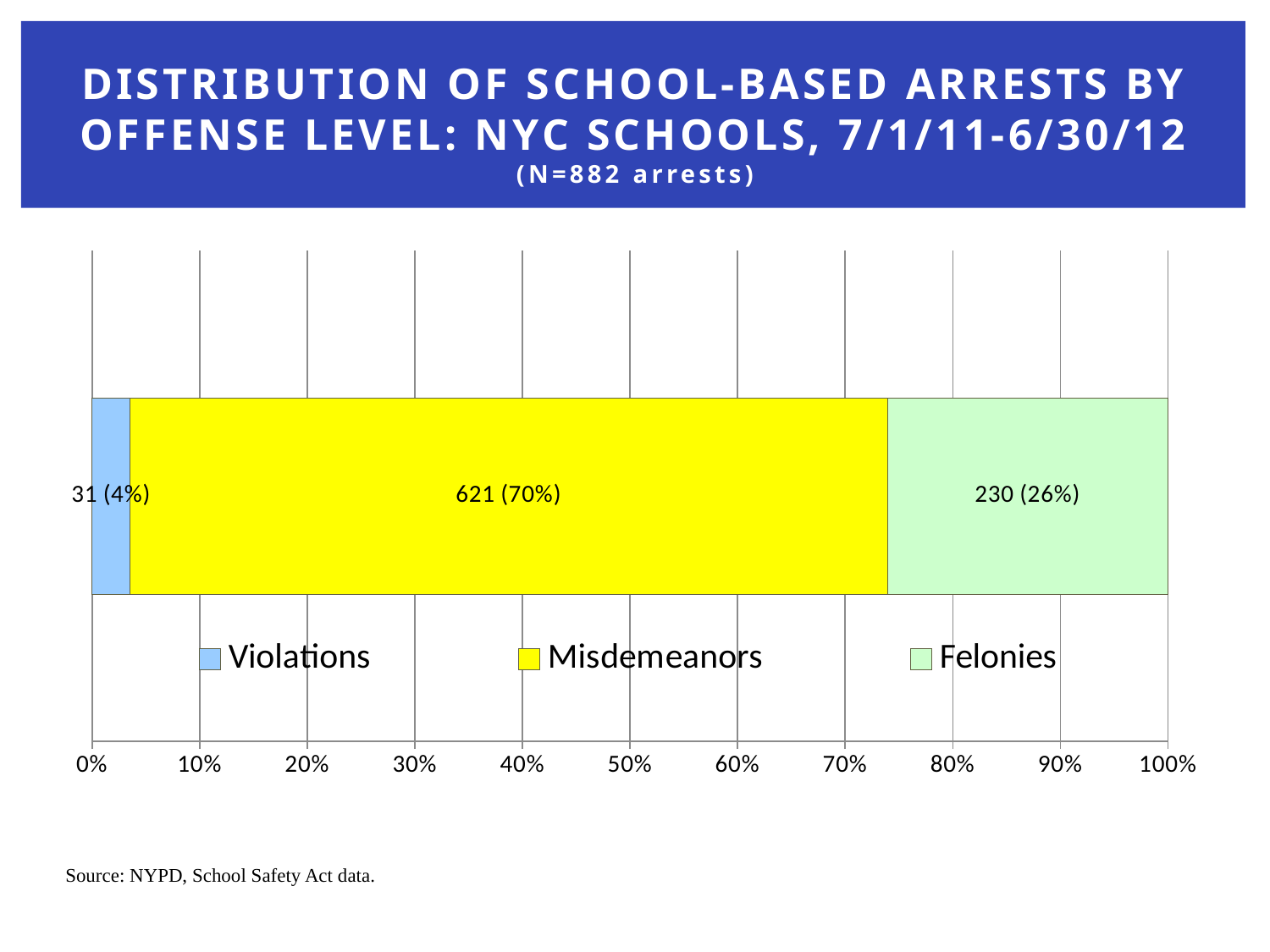
How many arrests were Misdemeanors? 621 How many series does the legend list? 3 Which offense level accounts for the smallest share of arrests? Violations How many arrests were Violations? 31 Which offense level accounts for the largest share of arrests? Misdemeanors How many more arrests were Felonies than Violations? 199 What is the total number of arrests across all three offense levels in the bar? 882 What kind of chart is shown on the slide? Stacked bar chart What is the total number of arrests (N) stated in the chart title? 882 What percentage of arrests were Felonies? 26% What colour represents Misdemeanors in the chart? Yellow Which had more arrests, Misdemeanors or Felonies? Misdemeanors